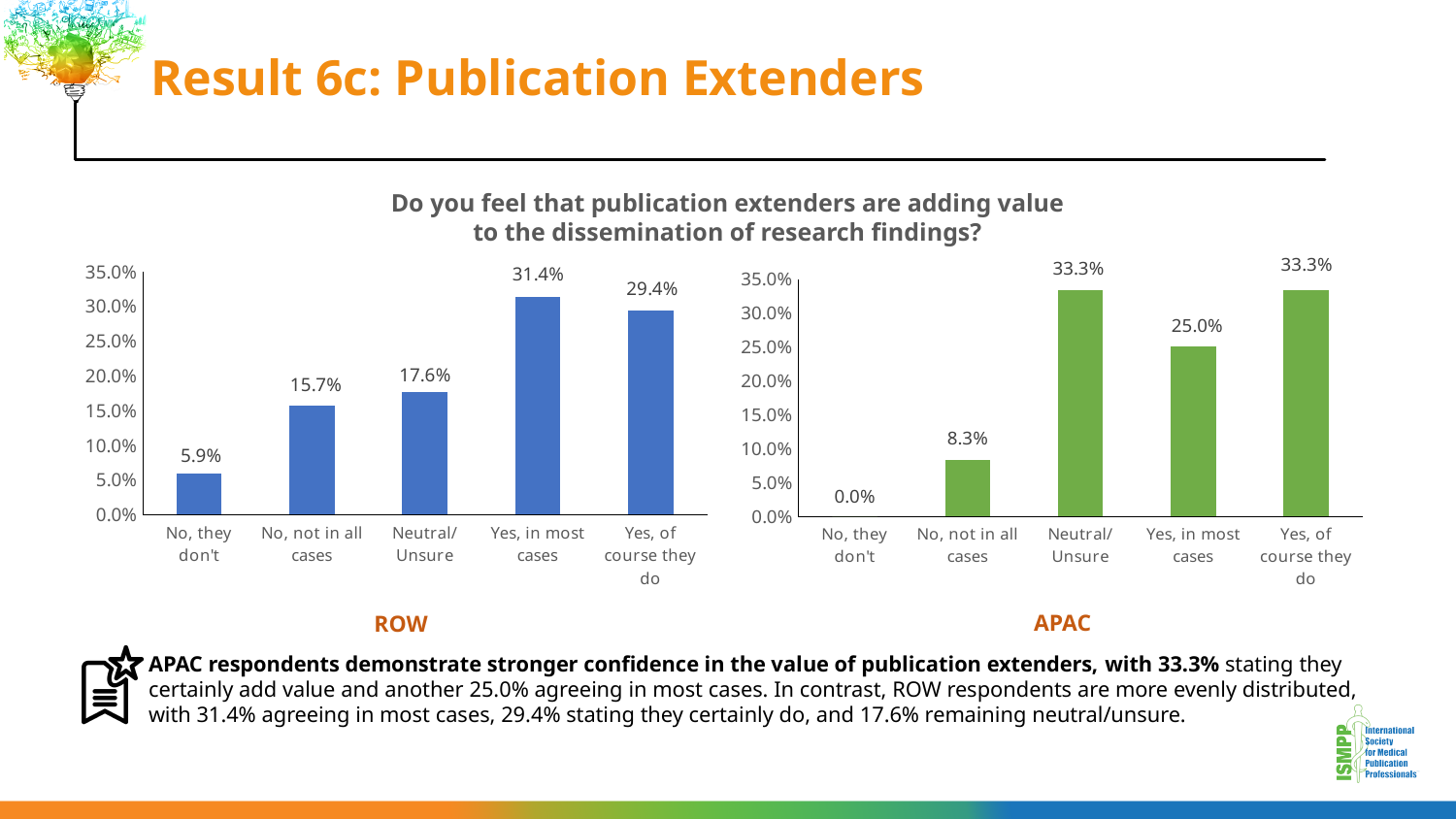
How many categories are shown in the APAC chart? 5 In the ROW chart, which category has the highest value? Yes, in most cases In the ROW chart, which is larger: "No, not in all cases" or "Neutral/Unsure"? Neutral/Unsure In the ROW chart, which category has the lowest value? No, they don't In the APAC chart, what is the value for "No, not in all cases"? 8.3% In the APAC chart, which category has the lowest value? No, they don't In the ROW chart, what is the difference between "Yes, in most cases" and "Yes, of course they do"? 2.0% In the APAC chart, what is the difference between "Neutral/Unsure" and "Yes, in most cases"? 8.3% What colour are the bars in the APAC chart? Green In the APAC chart, is the value for "Yes, in most cases" greater or less than 20.0%? greater What type of chart is the ROW chart? Bar chart In the ROW chart, what is the value for "Yes, in most cases"? 31.4%